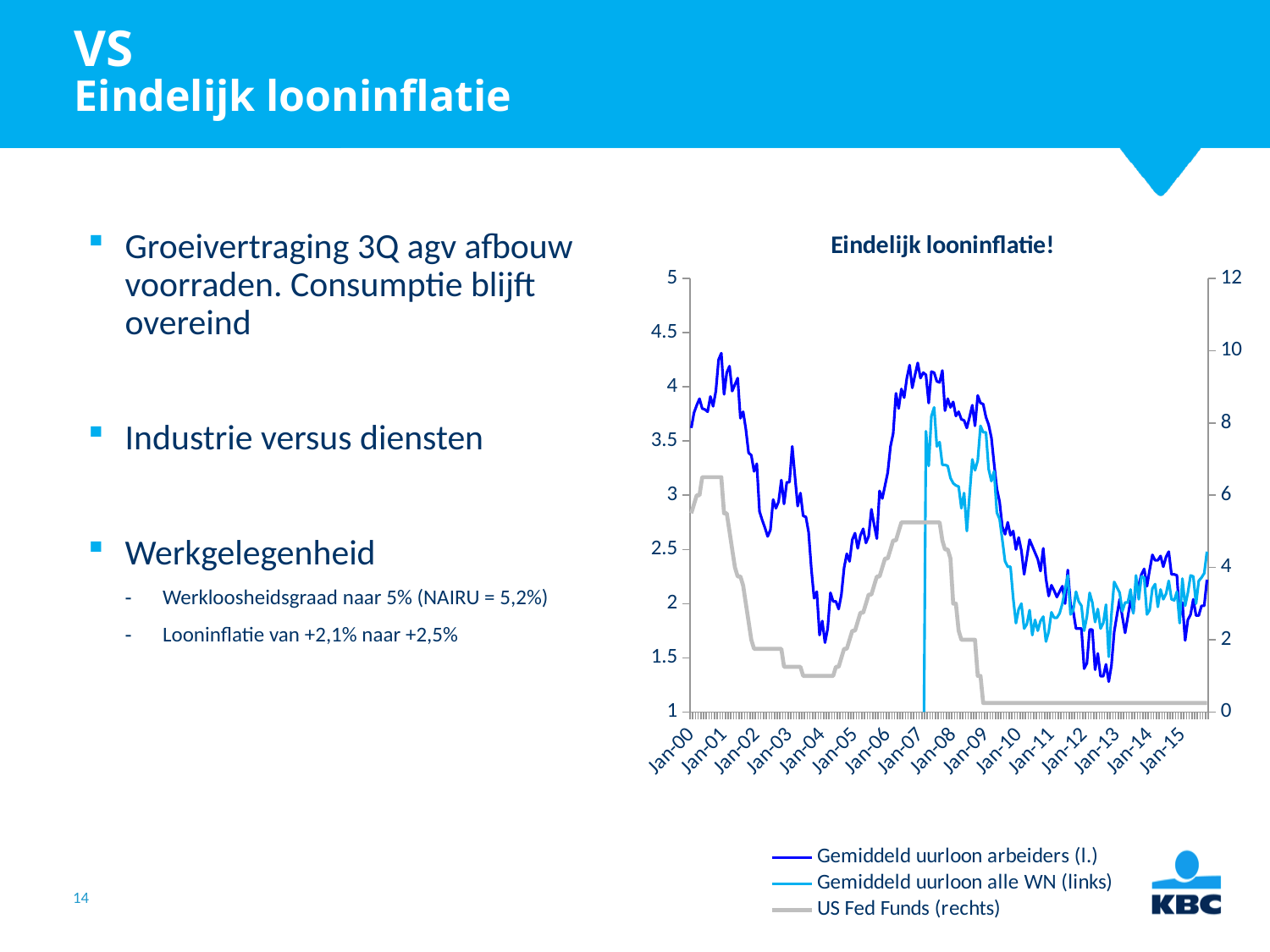
Is the value of US Fed Funds around Jan-10 greater or less than 2 on the right axis? less How many year labels are shown on the x axis of the chart? 16 What is the title of the chart? Eindelijk looninflatie! Is the value of Gemiddeld uurloon arbeiders around Jan-07 greater or less than 3.5 on the left axis? greater Is the value of US Fed Funds around Jan-01 greater or less than 4 on the right axis? greater What kind of chart is shown on the slide? line chart How many series does the chart legend list? 3 Does the US Fed Funds series rise or fall between Jan-07 and Jan-09? fall Does the Gemiddeld uurloon arbeiders series rise or fall between Jan-04 and Jan-07? rise Which series in the chart is plotted against the right-hand axis? US Fed Funds (rechts)